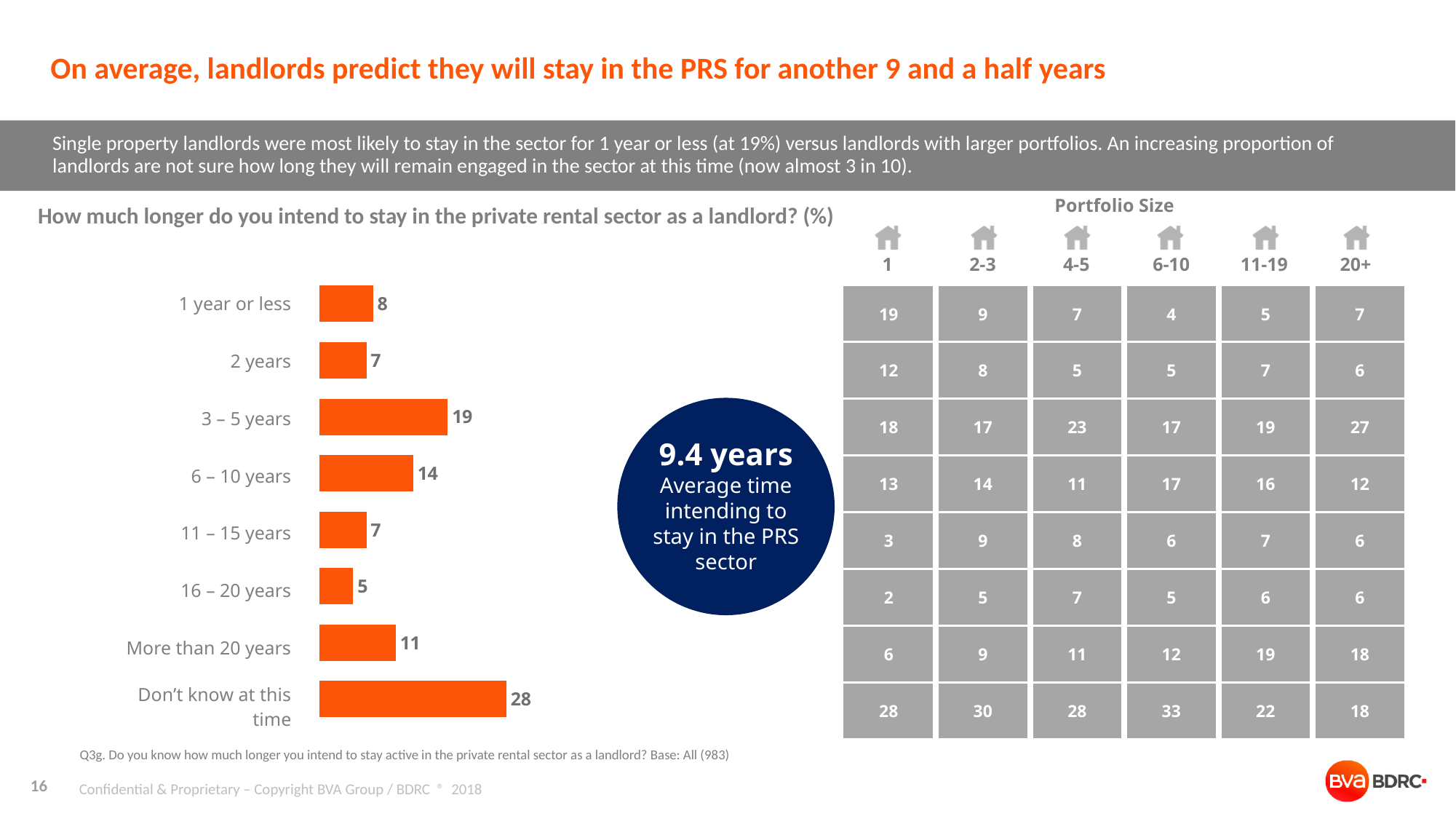
What value is shown for '6 – 10 years' in the bar chart? 14 Which is larger: the value for '1 year or less' or the value for 'More than 20 years'? More than 20 years What is the difference between the values for 'Don't know at this time' and '3 – 5 years'? 9 What is the difference between the values for '6 – 10 years' and '16 – 20 years'? 9 What percentage of landlords intend to stay in the private rental sector for 3 – 5 years? 19 What type of chart is used to show how much longer landlords intend to stay in the private rental sector? Bar chart What colour are the bars in the bar chart? Orange Which category has the highest value in the bar chart? Don't know at this time Which category has the lowest value in the bar chart? 16 – 20 years What value is shown for 'More than 20 years' in the bar chart? 11 How many categories are shown in the bar chart? 8 What is the average time landlords intend to stay in the PRS sector, as shown in the circle on the slide? 9.4 years